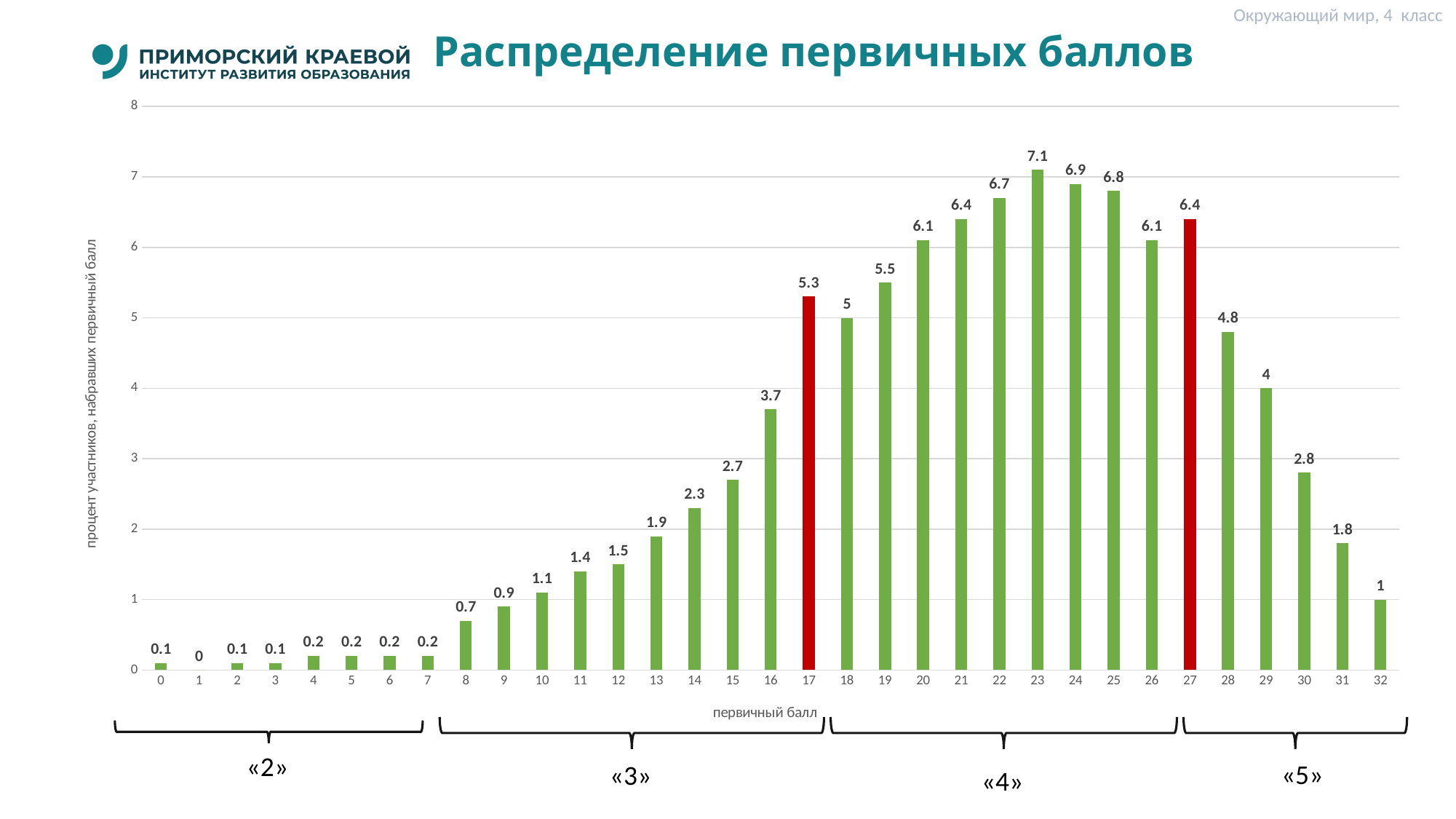
Which two primary scores are shown with red bars? 17 and 27 What is the difference between the values for primary scores 17 and 18? 0.3 Do the values rise or fall from primary score 23 to primary score 32? fall Which primary score has the highest percentage of participants? 23 What is the value for primary score 23? 7.1 What is the value for primary score 17? 5.3 Which has a larger value: primary score 24 or primary score 28? 24 What is the value for primary score 32? 1 How many primary score categories are shown on the x axis? 33 What type of chart is shown on the slide? bar chart Which primary score has the lowest percentage of participants? 1 What is the difference between the values for primary scores 23 and 32? 6.1